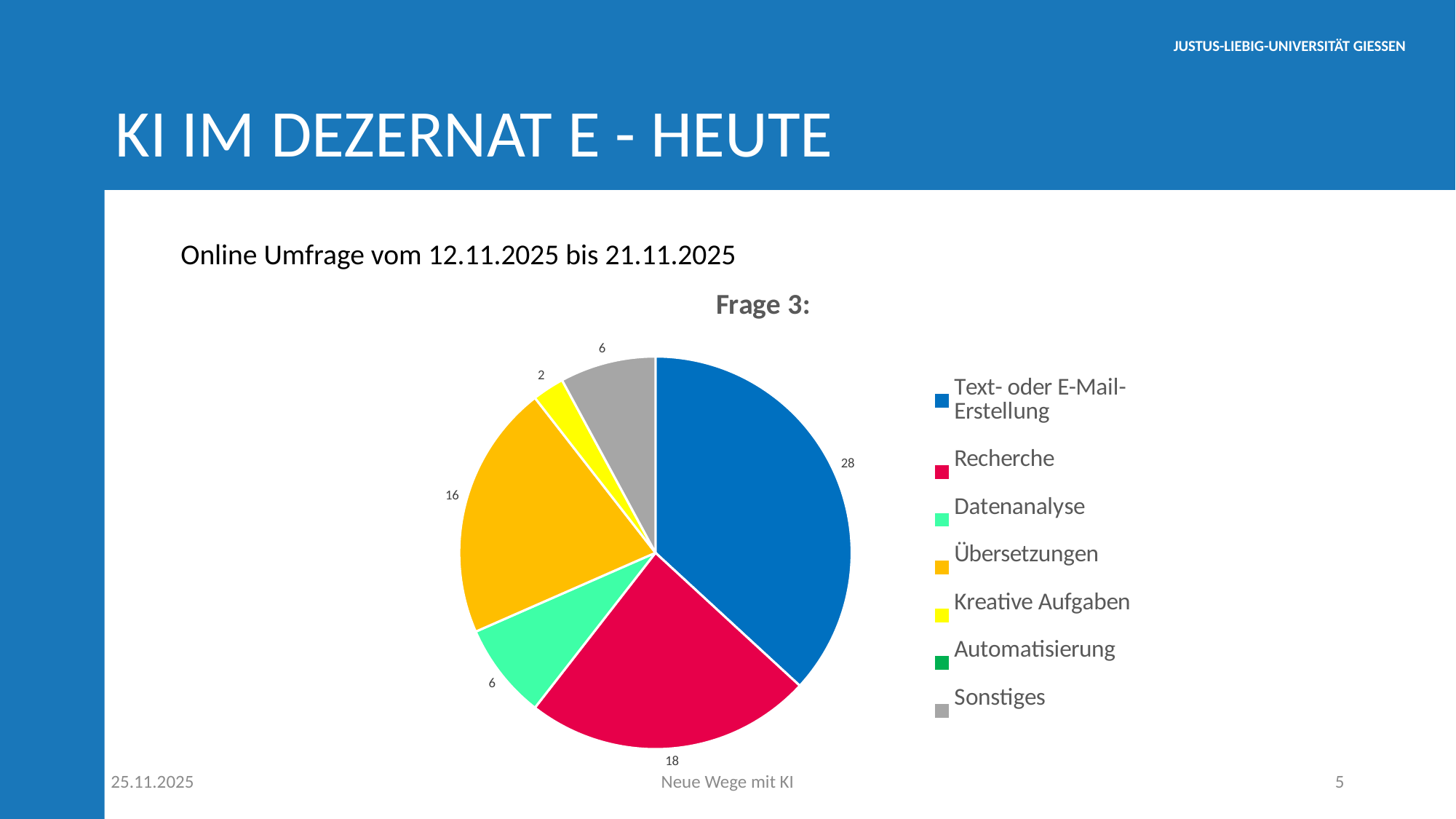
What is the value for Kreative Aufgaben in the pie chart? 2 Which is larger, the value for Recherche or the value for Übersetzungen? Recherche What is the value for Übersetzungen in the pie chart? 16 What is the value for Recherche in the pie chart? 18 What type of chart is shown on the slide? pie chart Which category has the largest slice in the pie chart? Text- oder E-Mail-Erstellung Which labelled slice has the smallest value in the pie chart? Kreative Aufgaben What is the difference between the values for Text- oder E-Mail-Erstellung and Recherche? 10 What is the title of the pie chart? Frage 3: What is the value for Datenanalyse in the pie chart? 6 How many entries does the legend of the pie chart list? 7 What is the value for Text- oder E-Mail-Erstellung in the pie chart? 28